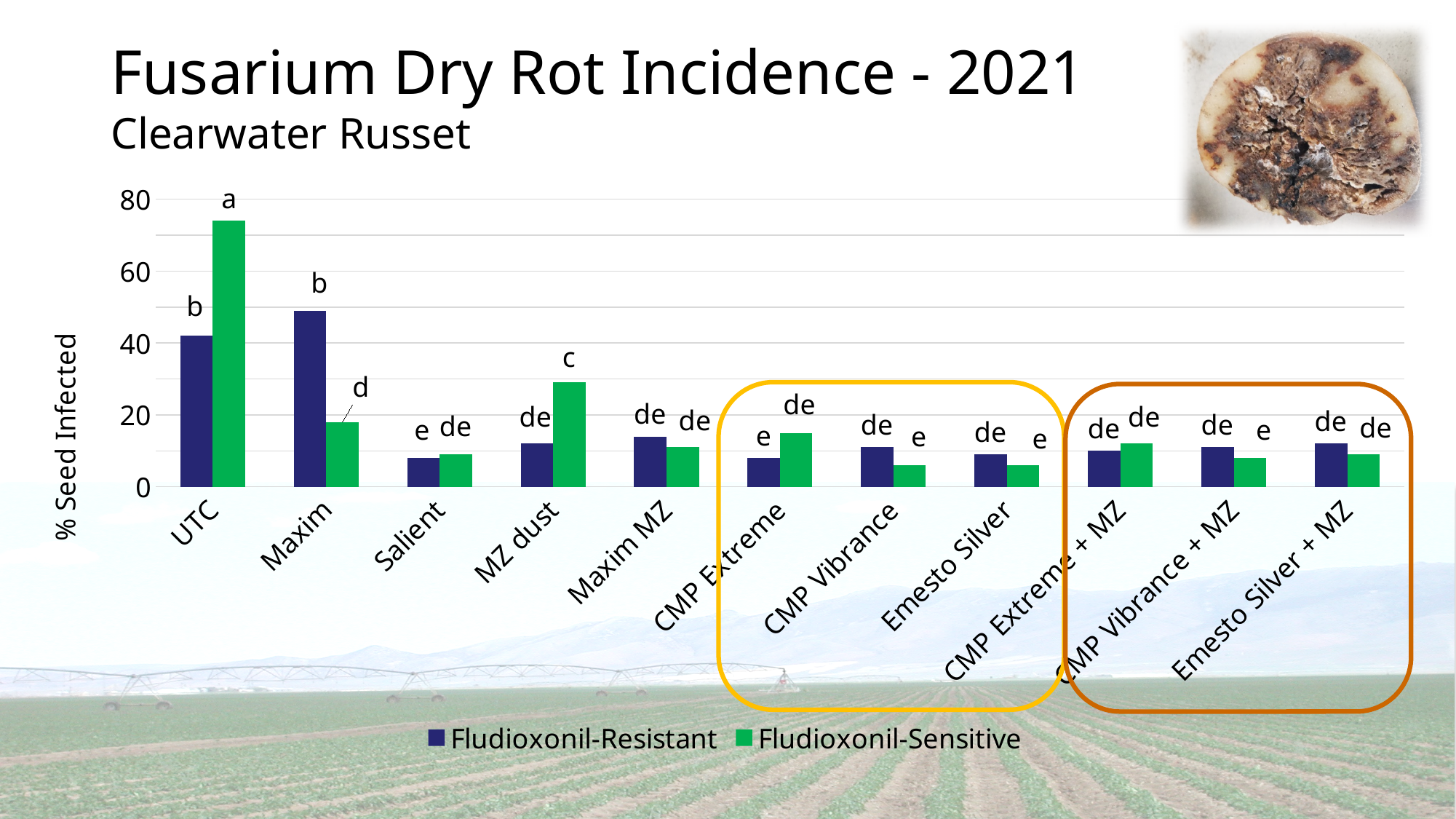
What is the label on the y axis of the chart? % Seed Infected Is the Fludioxonil-Resistant value for Salient greater or less than 20? less Which category has the highest Fludioxonil-Sensitive value? UTC For UTC, which series has the larger value, Fludioxonil-Resistant or Fludioxonil-Sensitive? Fludioxonil-Sensitive Is the Fludioxonil-Resistant value for Maxim greater or less than 40? greater Which category has the highest Fludioxonil-Resistant value? Maxim Is the Fludioxonil-Sensitive value for UTC greater or less than 60? greater How many series does the legend list? 2 How many treatment categories are shown on the x axis? 11 For Maxim, which series has the larger value, Fludioxonil-Resistant or Fludioxonil-Sensitive? Fludioxonil-Resistant What kind of chart is shown on the slide? bar chart